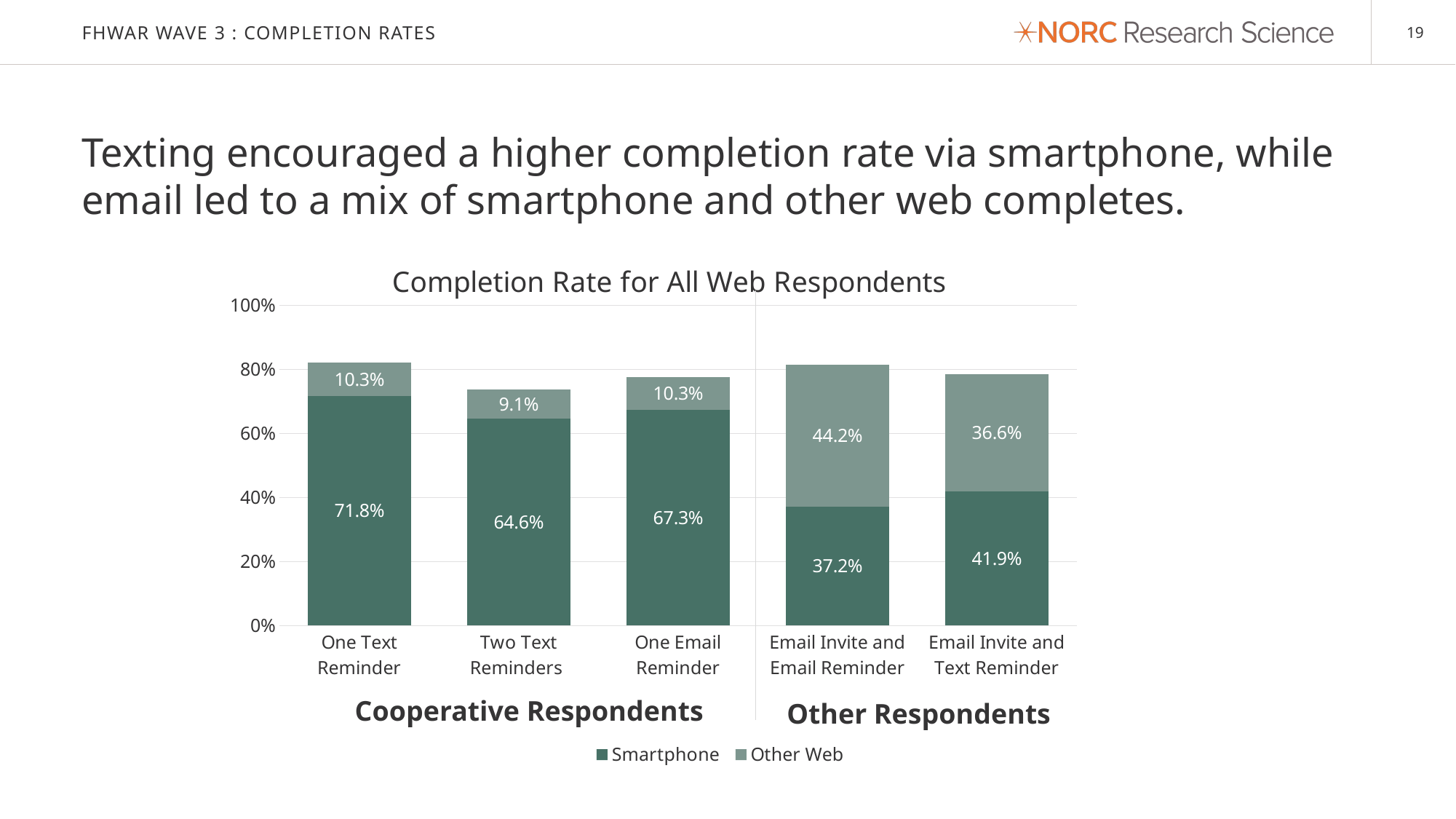
How many series does the legend list? 2 Is the total completion rate for Two Text Reminders greater or less than 80%? less What is the Smartphone completion rate for One Text Reminder? 71.8% What is the Other Web completion rate for Two Text Reminders? 9.1% How many categories are shown on the x axis? 5 Which category has the lowest Smartphone completion rate? Email Invite and Email Reminder What is the difference between the Smartphone completion rates for One Text Reminder and Two Text Reminders? 7.2 percentage points What is the Smartphone completion rate for Email Invite and Email Reminder? 37.2% What is the total completion rate for One Text Reminder (Smartphone plus Other Web)? 82.1% Which is larger, the Smartphone rate for Email Invite and Text Reminder or the Other Web rate for Email Invite and Text Reminder? Smartphone (41.9%) Which category has the highest Other Web completion rate? Email Invite and Email Reminder Which category has the highest Smartphone completion rate? One Text Reminder